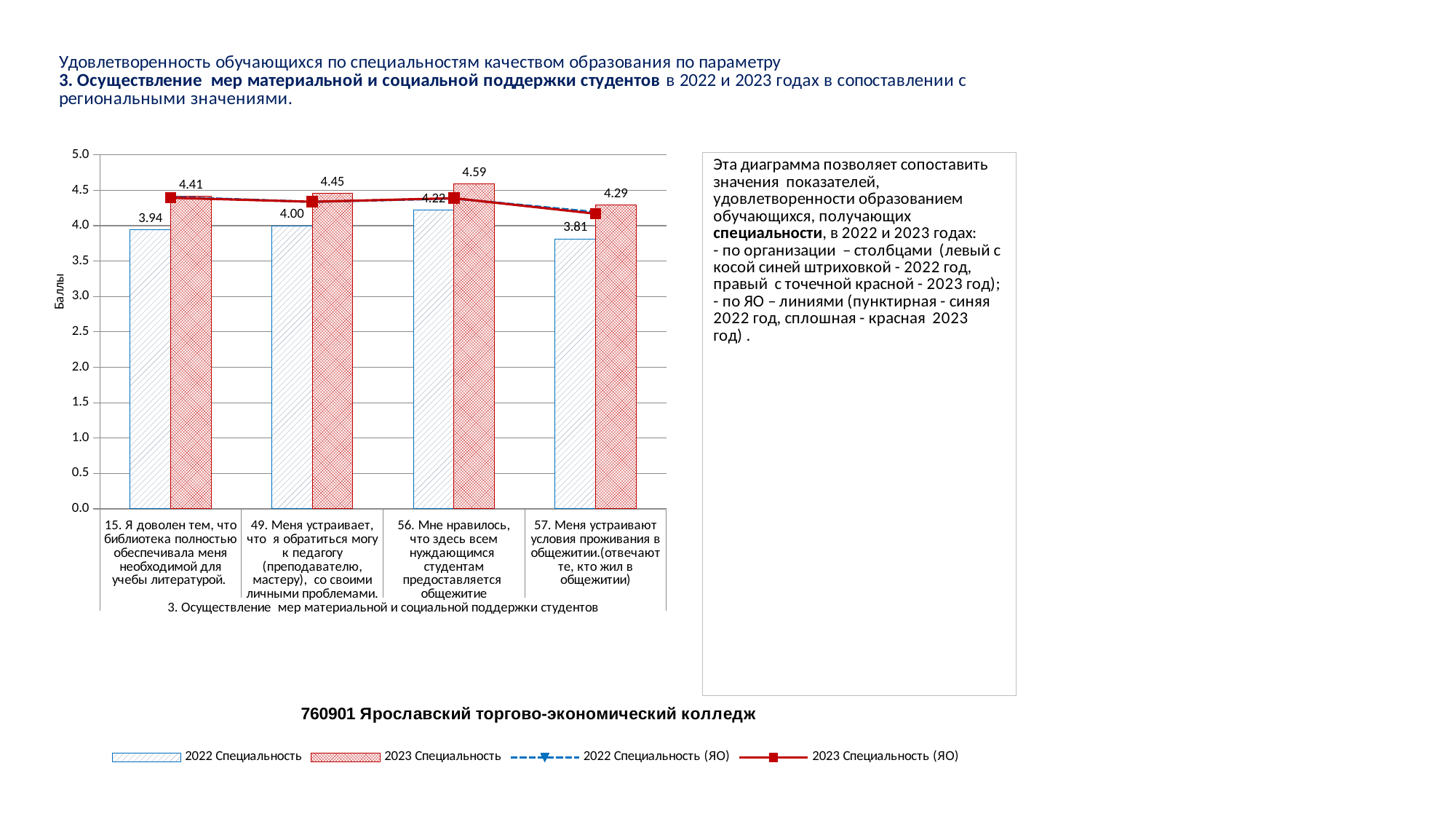
What is the 2022 Специальность value for question 57 (Меня устраивают условия проживания в общежитии)? 3.81 What is the 2023 Специальность value for question 56 (Мне нравилось, что здесь всем нуждающимся студентам предоставляется общежитие)? 4.59 Which is larger for question 49: the 2022 Специальность value or the 2023 Специальность value? 2023 Специальность What type of chart is shown on the slide? Bar chart with line series What is the 2022 Специальность value for question 15 (Я доволен тем, что библиотека полностью обеспечивала меня необходимой для учебы литературой)? 3.94 How many question categories are shown on the x axis? 4 Which question has the highest 2023 Специальность value? 56. Мне нравилось, что здесь всем нуждающимся студентам предоставляется общежитие Which question has the lowest 2022 Специальность value? 57. Меня устраивают условия проживания в общежитии What is the difference between the 2023 and 2022 Специальность values for question 57? 0.48 How many series does the legend list? 4 What is the 2023 Специальность value for question 49 (Меня устраивает, что я обратиться могу к педагогу)? 4.45 What is the label of the y axis? Баллы